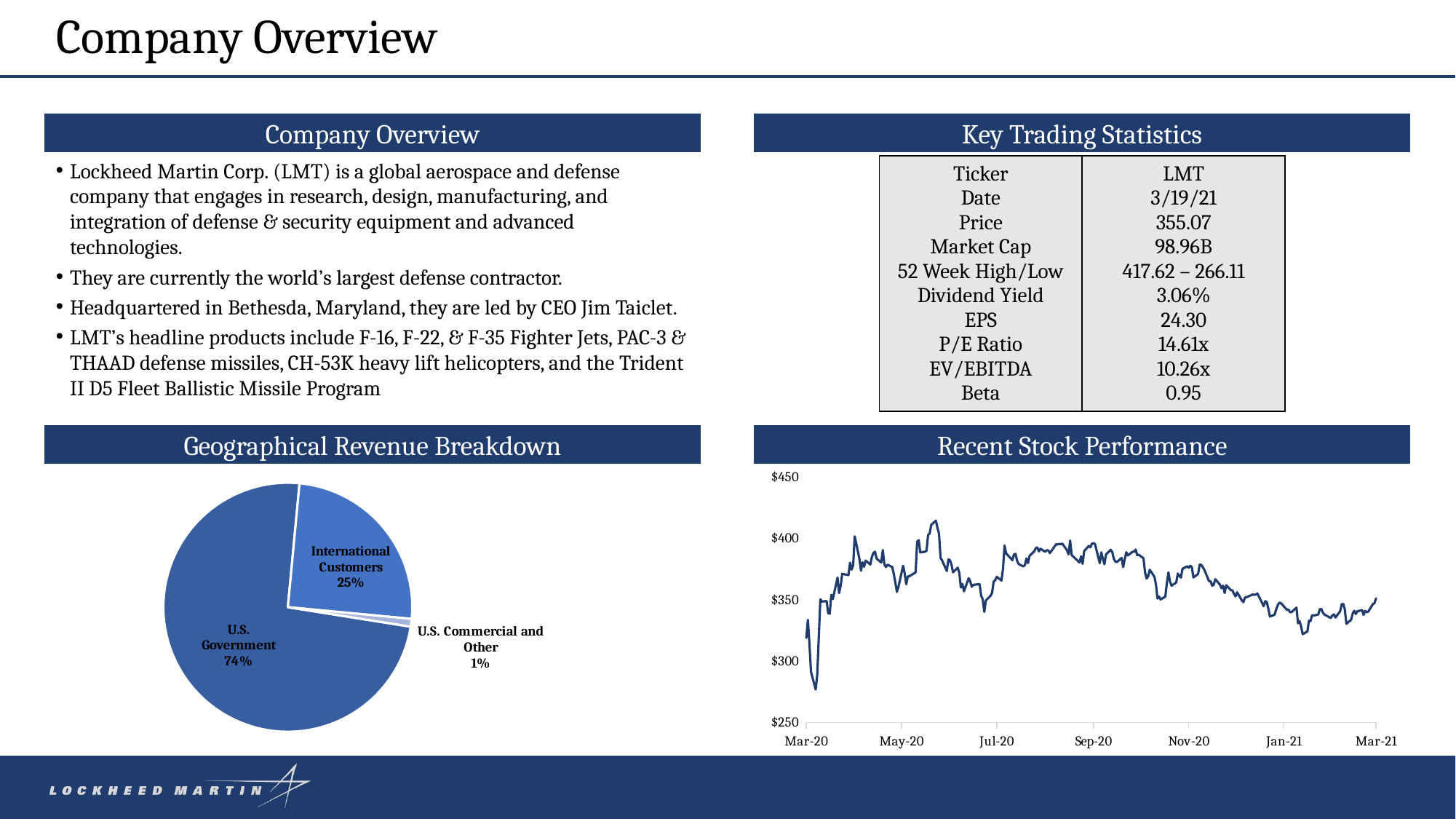
In the Geographical Revenue Breakdown chart, which category has the largest share? U.S. Government In the Geographical Revenue Breakdown chart, what share of revenue comes from U.S. Commercial and Other? 1% In the Recent Stock Performance chart, is the highest point of the line greater or less than $400? greater In the Recent Stock Performance chart, does the stock price rise or fall between Sep-20 and Jan-21? Fall In the Geographical Revenue Breakdown chart, how many percentage points larger is U.S. Government than International Customers? 49 What kind of chart is the Geographical Revenue Breakdown chart? Pie chart In the Geographical Revenue Breakdown chart, what share of revenue comes from U.S. Government? 74% In the Geographical Revenue Breakdown chart, which category has the smallest share? U.S. Commercial and Other In the Recent Stock Performance chart, is the lowest point of the line greater or less than $300? less What kind of chart is the Recent Stock Performance chart? Line chart In the Geographical Revenue Breakdown chart, what share of revenue comes from International Customers? 25% In the Geographical Revenue Breakdown chart, how many categories are shown? 3